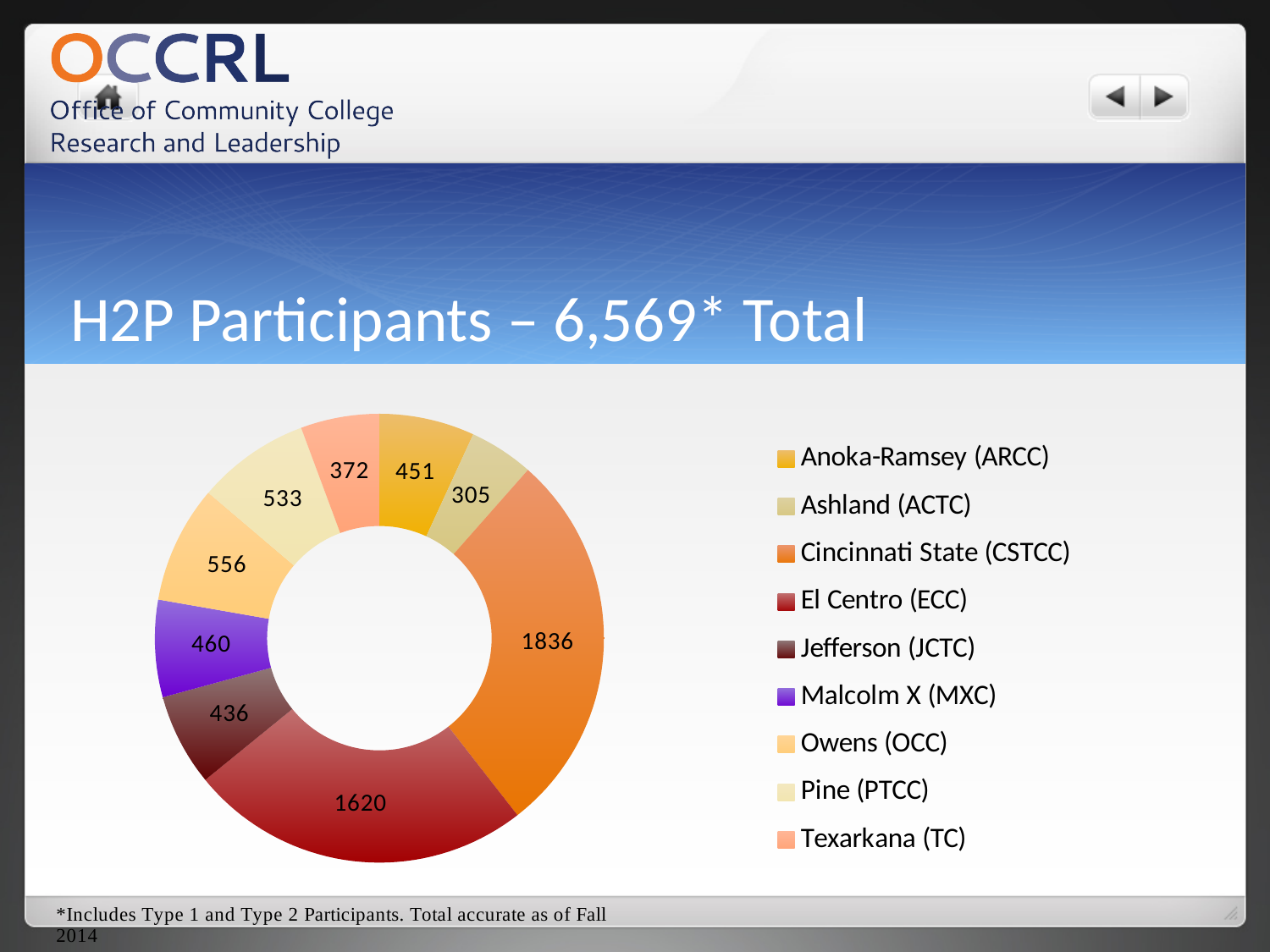
What is the value for Texarkana (TC)? 372 What is the difference between Malcolm X (MXC) and Jefferson (JCTC)? 24 Which has more participants, Owens (OCC) or Pine (PTCC)? Owens (OCC) Which college has the smallest number of H2P participants? Ashland (ACTC) What is the value for Ashland (ACTC)? 305 What total number of H2P participants is stated in the slide title? 6,569 What type of chart is shown on the slide? Doughnut (pie) chart How many colleges are shown in the chart? 9 Which college has the largest number of H2P participants? Cincinnati State (CSTCC) What is the difference between Cincinnati State (CSTCC) and El Centro (ECC)? 216 What is the value for El Centro (ECC)? 1620 How many participants does Cincinnati State (CSTCC) have? 1836